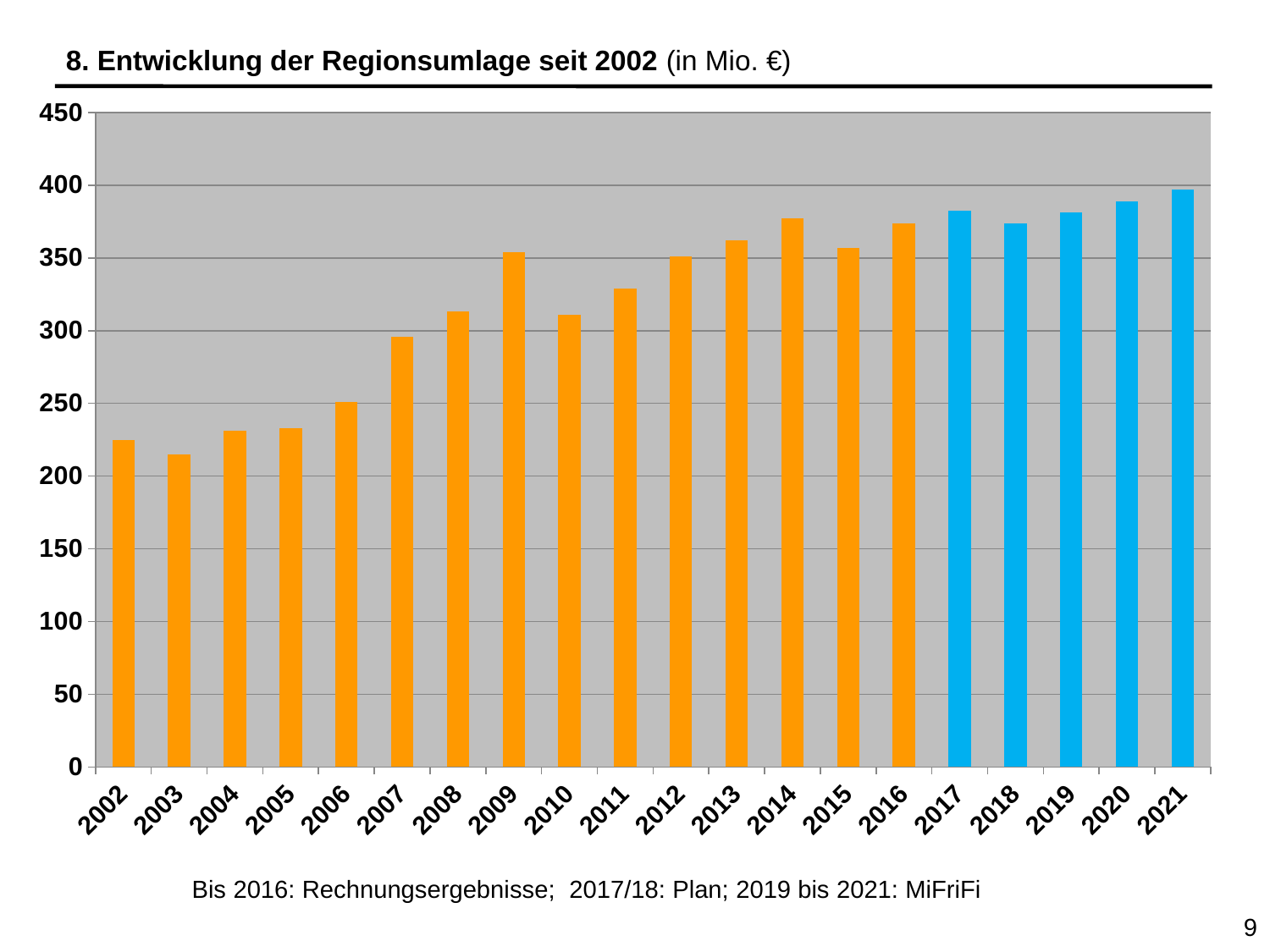
What colour are the bars for the years 2017 to 2021? blue Which year has the lowest Regionsumlage in the chart? 2003 What kind of chart is shown on the slide? bar chart Which year has the larger value, 2014 or 2015? 2014 Is the value for 2002 greater or less than 200? greater Do the values generally rise or fall from 2002 to 2021? rise Which year has the highest Regionsumlage in the chart? 2021 How many years (bars) are plotted in the chart? 20 Which year has the larger value, 2009 or 2010? 2009 Is the value for 2011 greater or less than 350? less